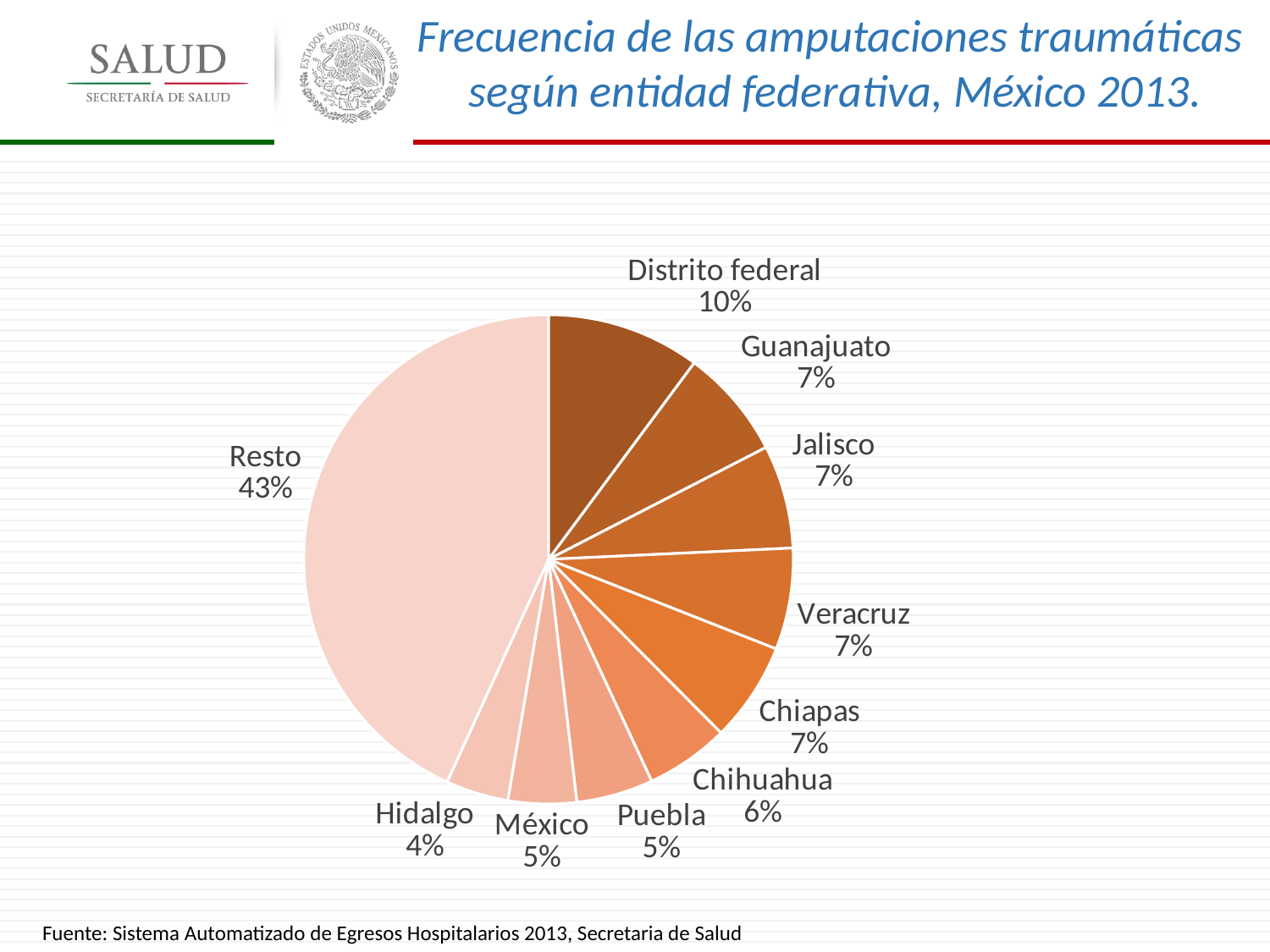
What is the difference in percentage points between Distrito federal and Puebla? 5 What percentage is shown for Hidalgo? 4% What percentage is shown for Chihuahua? 6% Which slice of the pie is the smallest? Hidalgo What type of chart is shown on the slide? pie chart What is the title of the chart on the slide? Frecuencia de las amputaciones traumáticas según entidad federativa, México 2013. Which slice of the pie is the largest? Resto What percentage is shown for Resto? 43% What share of the pie does Distrito federal have? 10% How many slices does the pie chart have? 10 Which is larger, the share for Chihuahua or the share for Hidalgo? Chihuahua What percentage is shown for Guanajuato? 7%